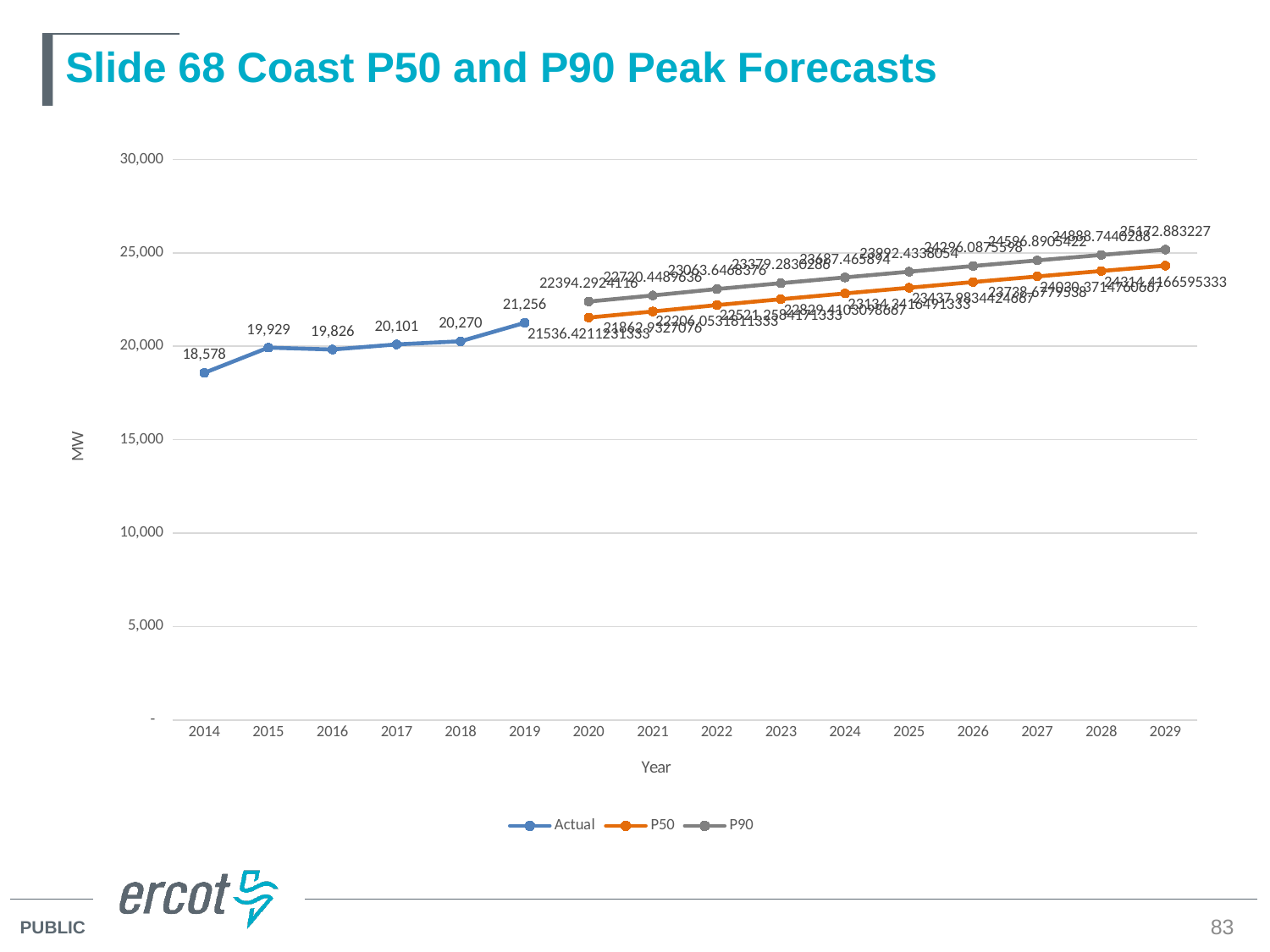
What is the difference between the Actual values for 2019 and 2014? 2,678 What is the Actual value for 2017? 20,101 Is the P90 value for 2029 greater or less than 25,000? greater Which year has the lowest Actual value? 2014 Which year has the highest Actual value? 2019 How many series does the legend list? 3 What is the Actual value for 2014? 18,578 Which is larger, the Actual value for 2015 or for 2016? 2015 What type of chart is shown on the slide? line chart Do the P90 values rise or fall from 2020 to 2029? rise Is the P50 value for 2020 greater or less than 25,000? less What is the Actual value for 2019? 21,256